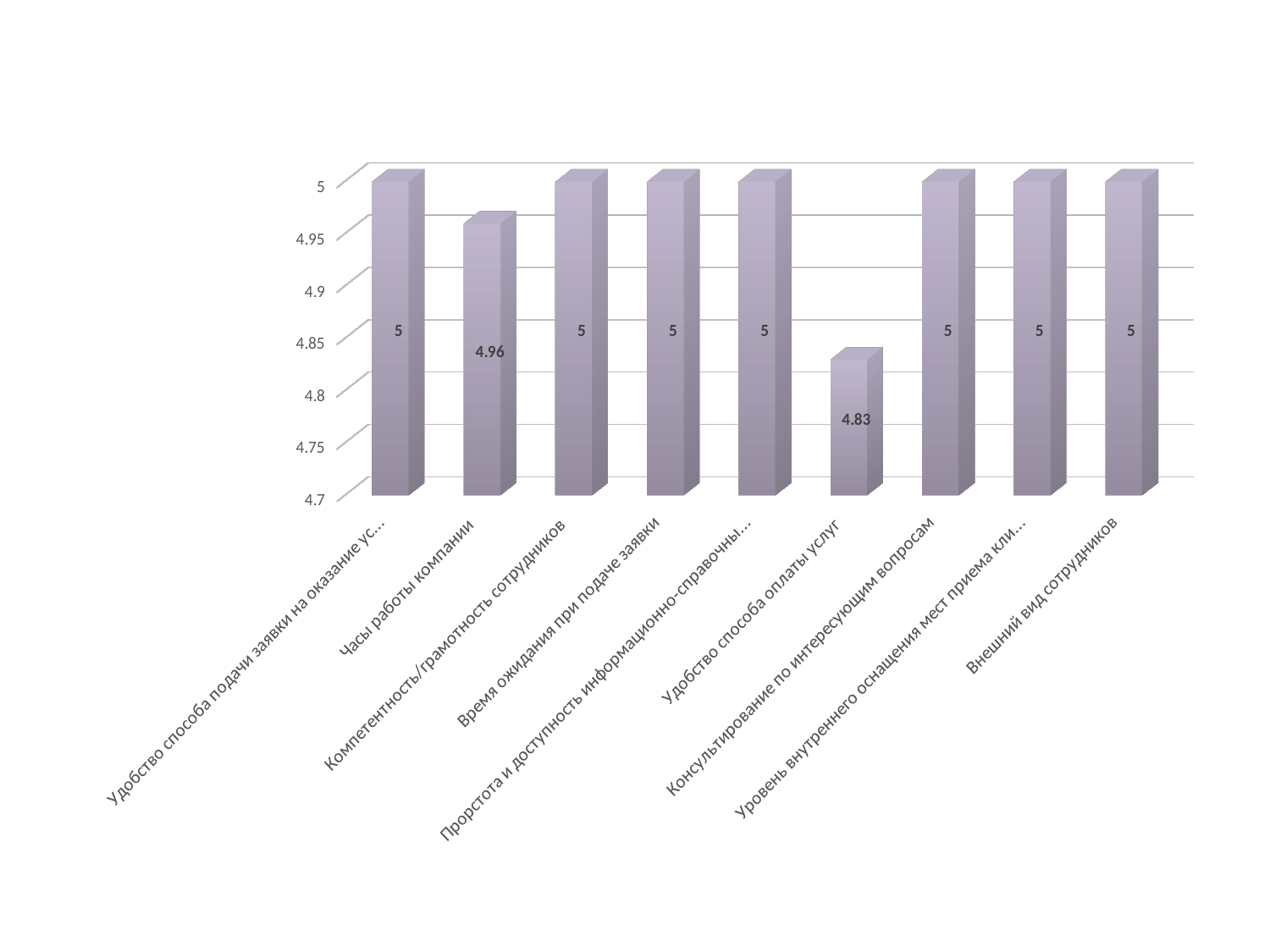
Is the value for Часы работы компании greater or less than 4.9? greater Which category has the lowest value? Удобство способа оплаты услуг What is the difference between the values for Компетентность/грамотность сотрудников and Удобство способа оплаты услуг? 0.17 What is the value for Время ожидания при подаче заявки? 5 How many categories are shown on the chart? 9 What is the value for Часы работы компании? 4.96 Which is larger, the value for Часы работы компании or the value for Удобство способа оплаты услуг? Часы работы компании Is the value for Удобство способа оплаты услуг greater or less than 4.85? less What kind of chart is shown on the slide? bar chart What is the difference between the values for Часы работы компании and Удобство способа оплаты услуг? 0.13 What is the value for Удобство способа оплаты услуг? 4.83 What is the value for Внешний вид сотрудников? 5